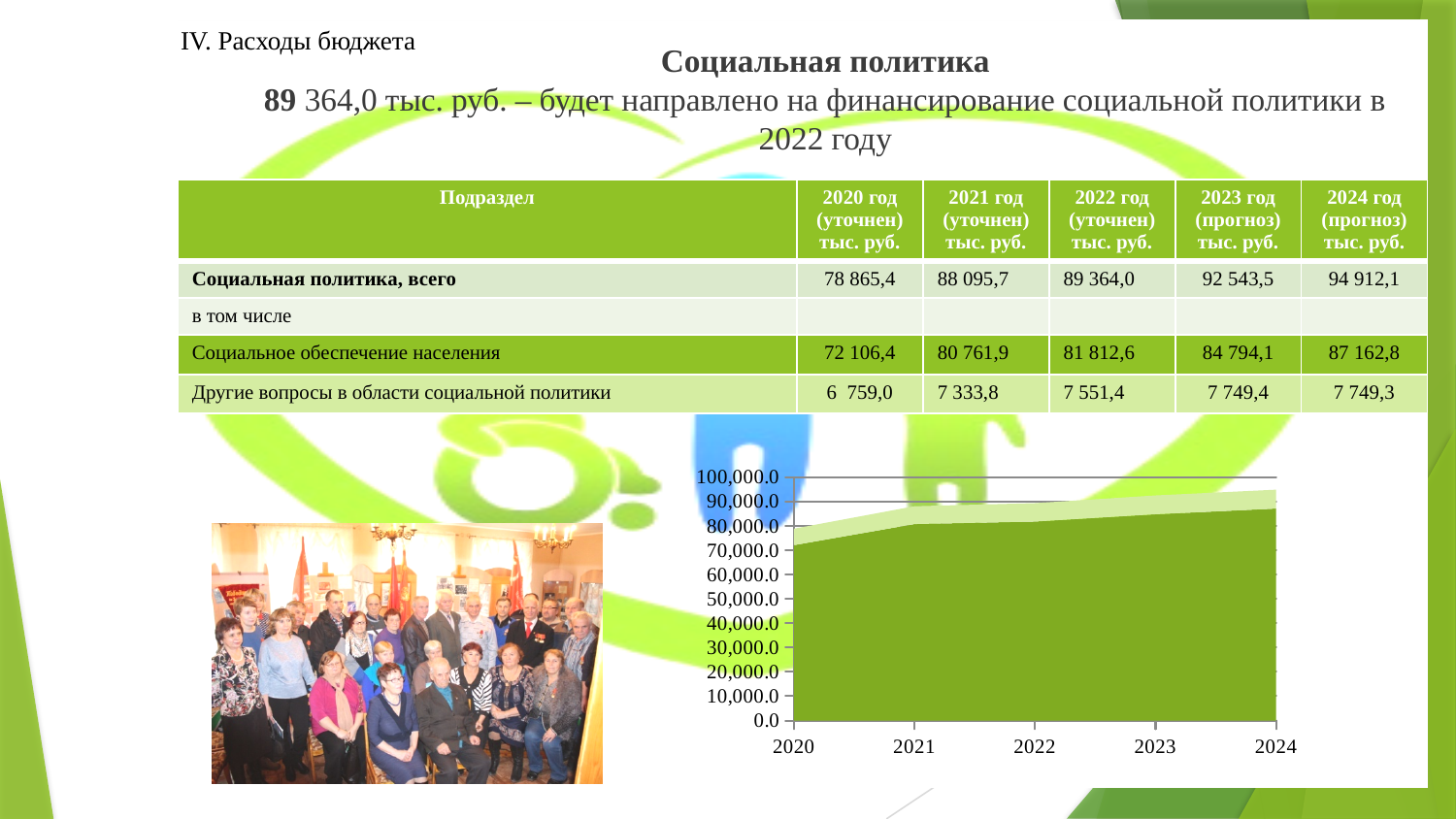
Is the total plotted value for 2024 greater or less than 90,000.0? greater In which year is the total plotted value lowest? 2020 In which year is the total plotted value highest? 2024 What kind of chart is shown at the bottom of the slide? area chart Does the total plotted value rise or fall from 2020 to 2024? rise Is the total plotted value for 2020 greater or less than 90,000.0? less Is the total plotted value for 2020 greater or less than 70,000.0? greater What is the highest tick value shown on the y axis of the chart? 100,000.0 How many years are plotted along the x axis of the chart? 5 Which years are shown on the x axis of the chart? 2020, 2021, 2022, 2023, 2024